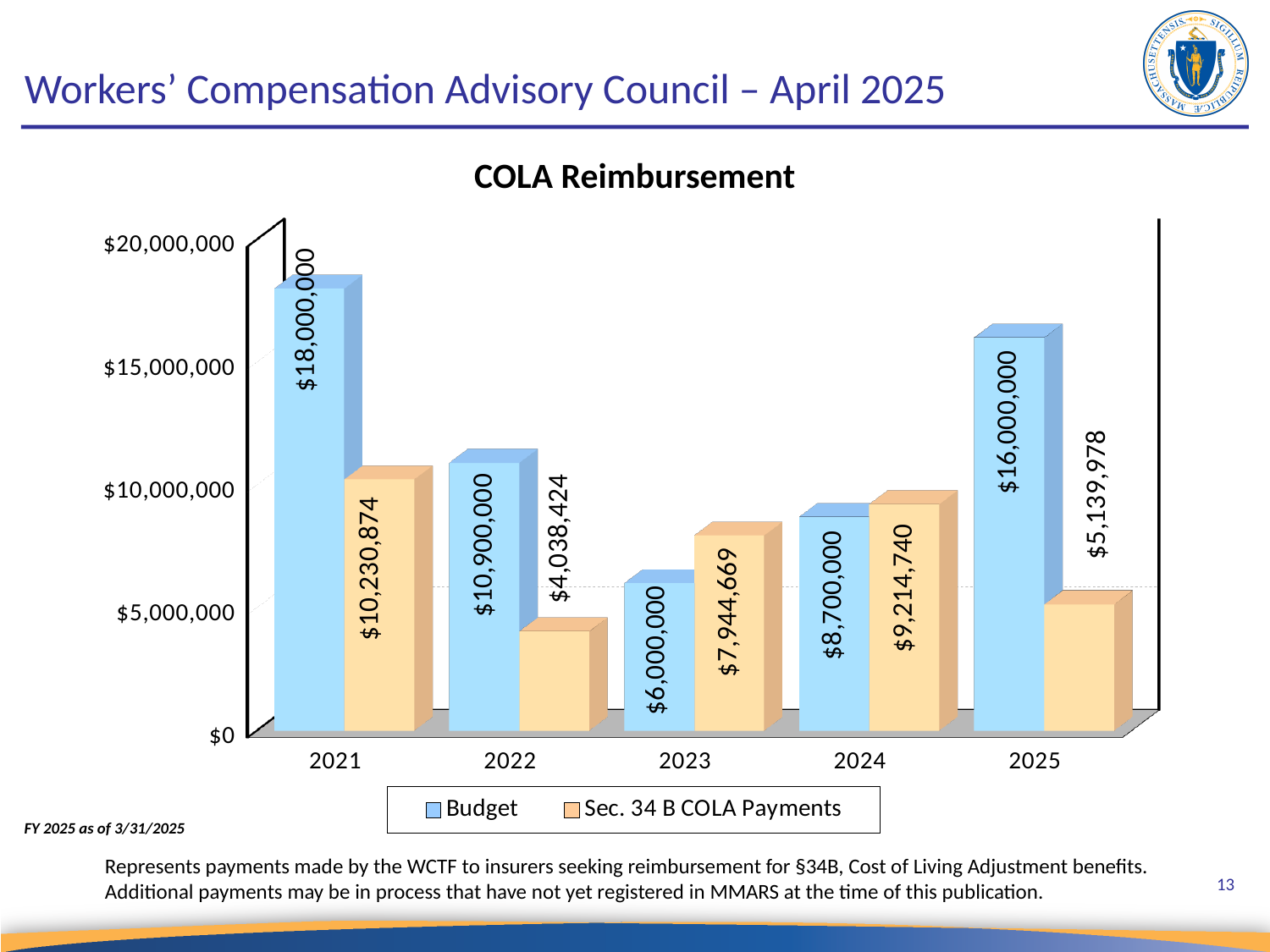
How many years are shown on the x axis? 5 Which year has the highest Budget value? 2021 What is the difference between the Budget and the Sec. 34 B COLA Payments in 2024? $514,740 In 2023, which is larger: the Budget or the Sec. 34 B COLA Payments? Sec. 34 B COLA Payments Which year has the lowest Sec. 34 B COLA Payments value? 2022 What is the Sec. 34 B COLA Payments value for 2023? $7,944,669 What kind of chart is shown on the slide? bar chart Is the Budget value for 2022 greater or less than $10,000,000? greater What is the Sec. 34 B COLA Payments value for 2025? $5,139,978 How many series does the legend list? 2 What is the title of the chart? COLA Reimbursement What is the Budget value for 2021? $18,000,000